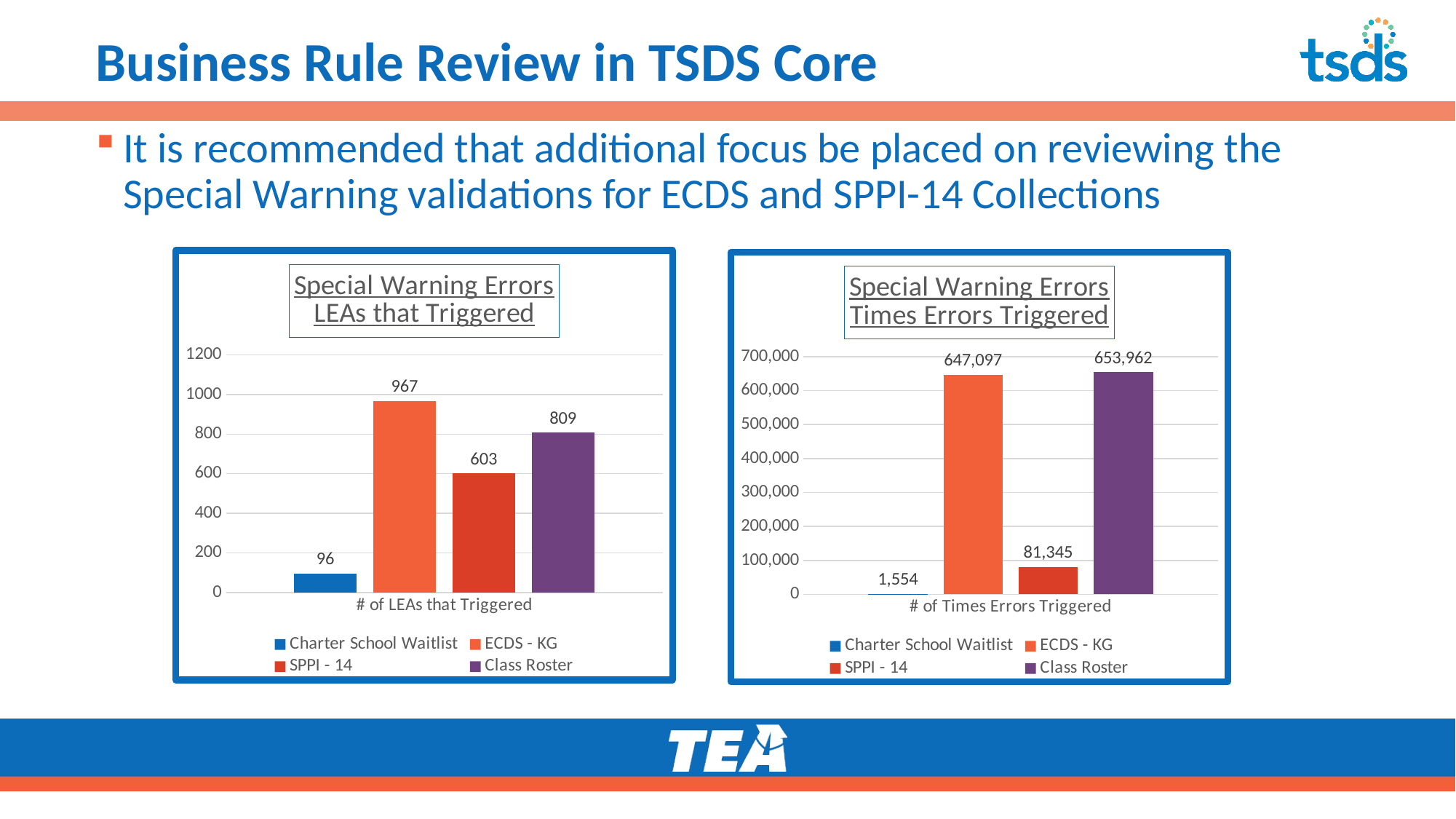
In the 'Special Warning Errors Times Errors Triggered' chart, which series has the highest value? Class Roster What kind of chart is the 'Special Warning Errors Times Errors Triggered' chart? bar chart In the 'Special Warning Errors LEAs that Triggered' chart, which is larger, Class Roster or SPPI - 14? Class Roster In the 'Special Warning Errors Times Errors Triggered' chart, what is the difference between Class Roster and ECDS - KG? 6,865 In the 'Special Warning Errors LEAs that Triggered' chart, which series has the lowest value? Charter School Waitlist In the 'Special Warning Errors LEAs that Triggered' chart, what is the difference between ECDS - KG and SPPI - 14? 364 In the 'Special Warning Errors Times Errors Triggered' chart, what is the value for SPPI - 14? 81,345 In the 'Special Warning Errors LEAs that Triggered' chart, what is the value for ECDS - KG? 967 How many series does the legend of the 'Special Warning Errors LEAs that Triggered' chart list? 4 In the 'Special Warning Errors LEAs that Triggered' chart, what is the value for Charter School Waitlist? 96 In the 'Special Warning Errors Times Errors Triggered' chart, is the value for SPPI - 14 greater or less than 100,000? less In the 'Special Warning Errors Times Errors Triggered' chart, what is the value for Class Roster? 653,962